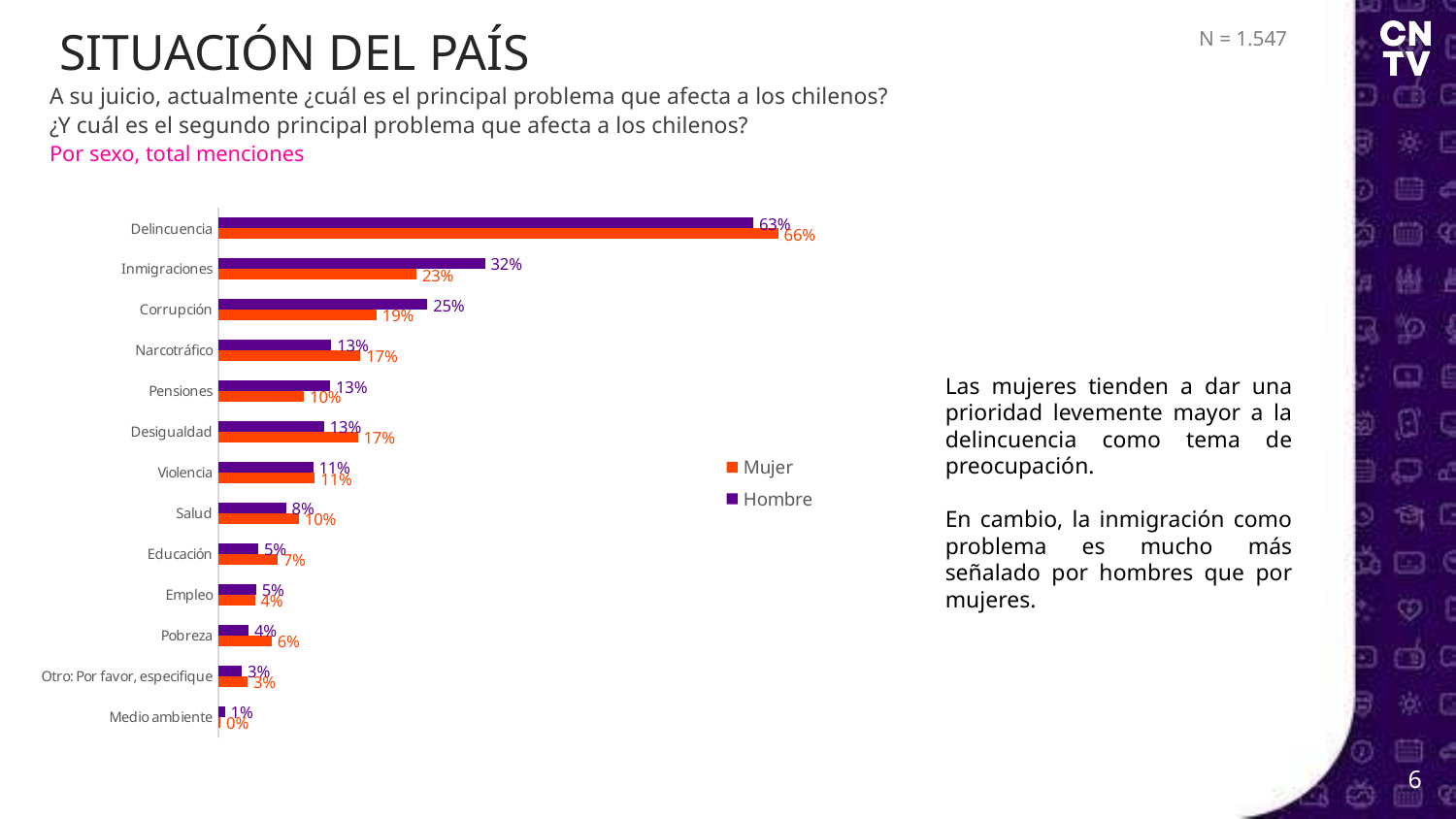
What is the difference between the Mujer and Hombre values for Delincuencia? 3% Which category has the highest value for Hombre? Delincuencia Which category has the lowest value for Mujer? Medio ambiente How many categories are plotted on the chart? 13 What is the value for Mujer for Corrupción? 19% What kind of chart is shown on the slide? bar chart What is the value for Mujer for Delincuencia? 66% For Narcotráfico, which is larger: the Mujer value or the Hombre value? Mujer Which colour represents the Hombre series in the legend? purple What is the value for Hombre for Inmigraciones? 32% What is the difference between the Hombre and Mujer values for Inmigraciones? 9% How many series does the legend list? 2